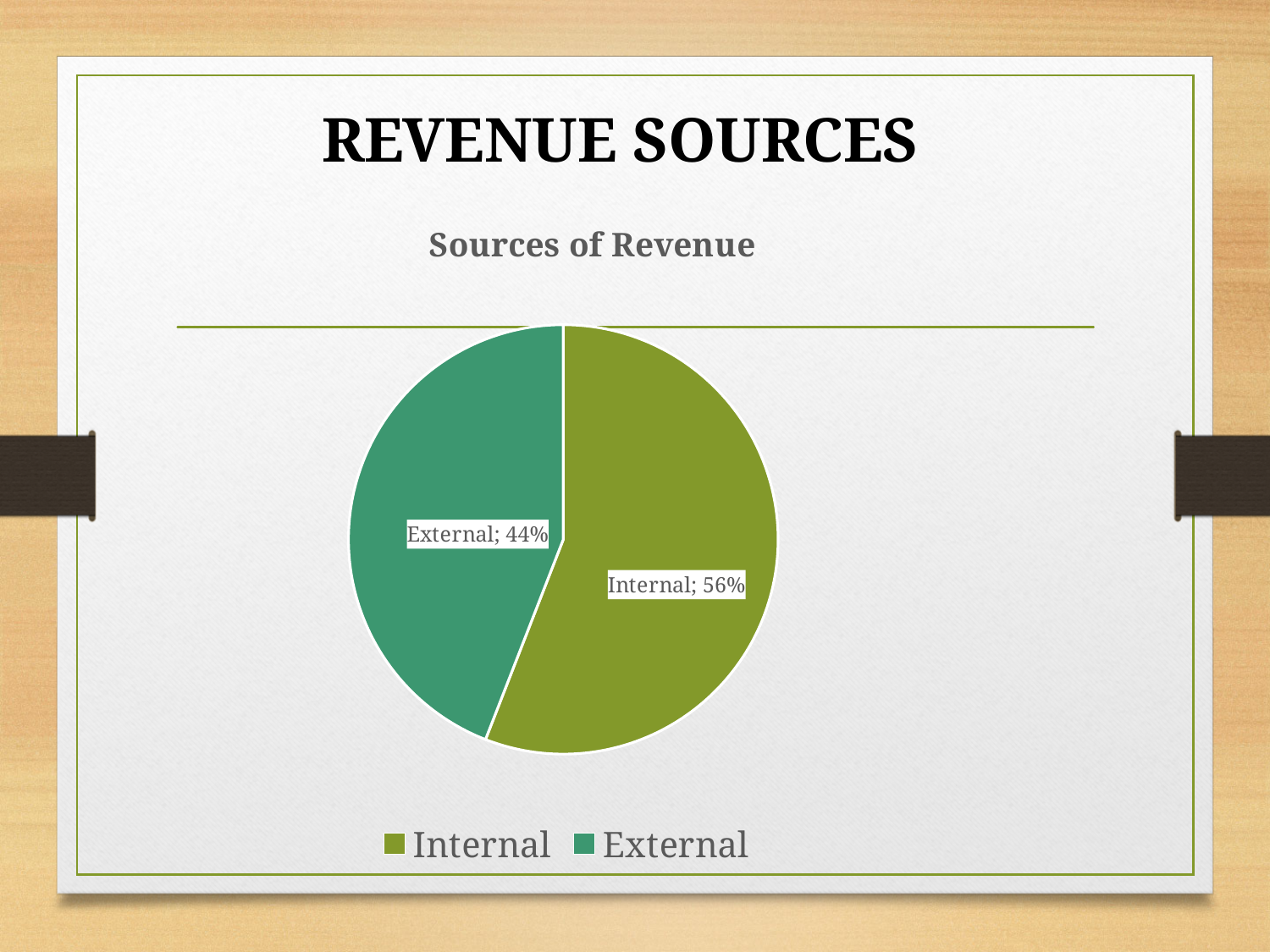
What kind of chart is shown on the slide? Pie chart Which colour represents the External slice in the pie chart? Teal green Which is larger, the Internal share or the External share? Internal What is the title of the chart? Sources of Revenue Which revenue source has the largest share of the pie? Internal What is the difference in percentage points between the Internal and External shares? 12 How many slices does the pie chart have? 2 What share of revenue comes from Internal sources? 56% How many entries does the legend list? 2 Which revenue source has the smallest share of the pie? External What share of revenue comes from External sources? 44%